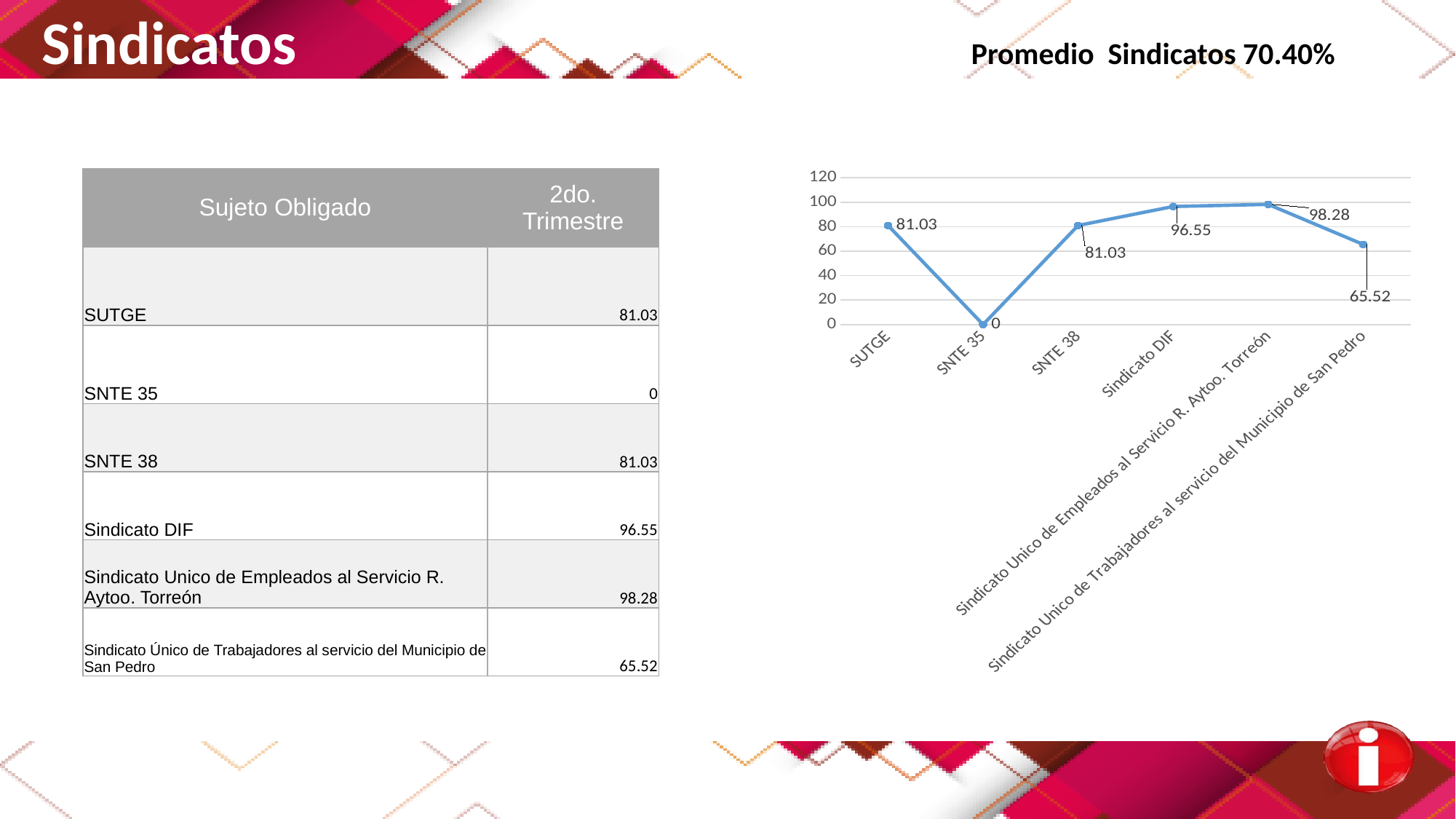
What is the value for Sindicato DIF in the chart? 96.55 Which is larger, the value for SNTE 38 or the value for Sindicato Unico de Trabajadores al servicio del Municipio de San Pedro? SNTE 38 What is the value for SNTE 35 in the chart? 0 What type of chart is shown on the slide? line chart How many categories are plotted on the x axis of the chart? 6 What is the highest value shown on the chart's vertical axis? 120 Which category has the highest value in the chart? Sindicato Unico de Empleados al Servicio R. Aytoo. Torreón Is the value for Sindicato DIF greater or less than 80? greater Which category has the lowest value in the chart? SNTE 35 What is the value for Sindicato Unico de Trabajadores al servicio del Municipio de San Pedro in the chart? 65.52 What is the difference between the values for Sindicato Unico de Empleados al Servicio R. Aytoo. Torreón and Sindicato DIF? 1.73 What is the value for SUTGE in the chart? 81.03